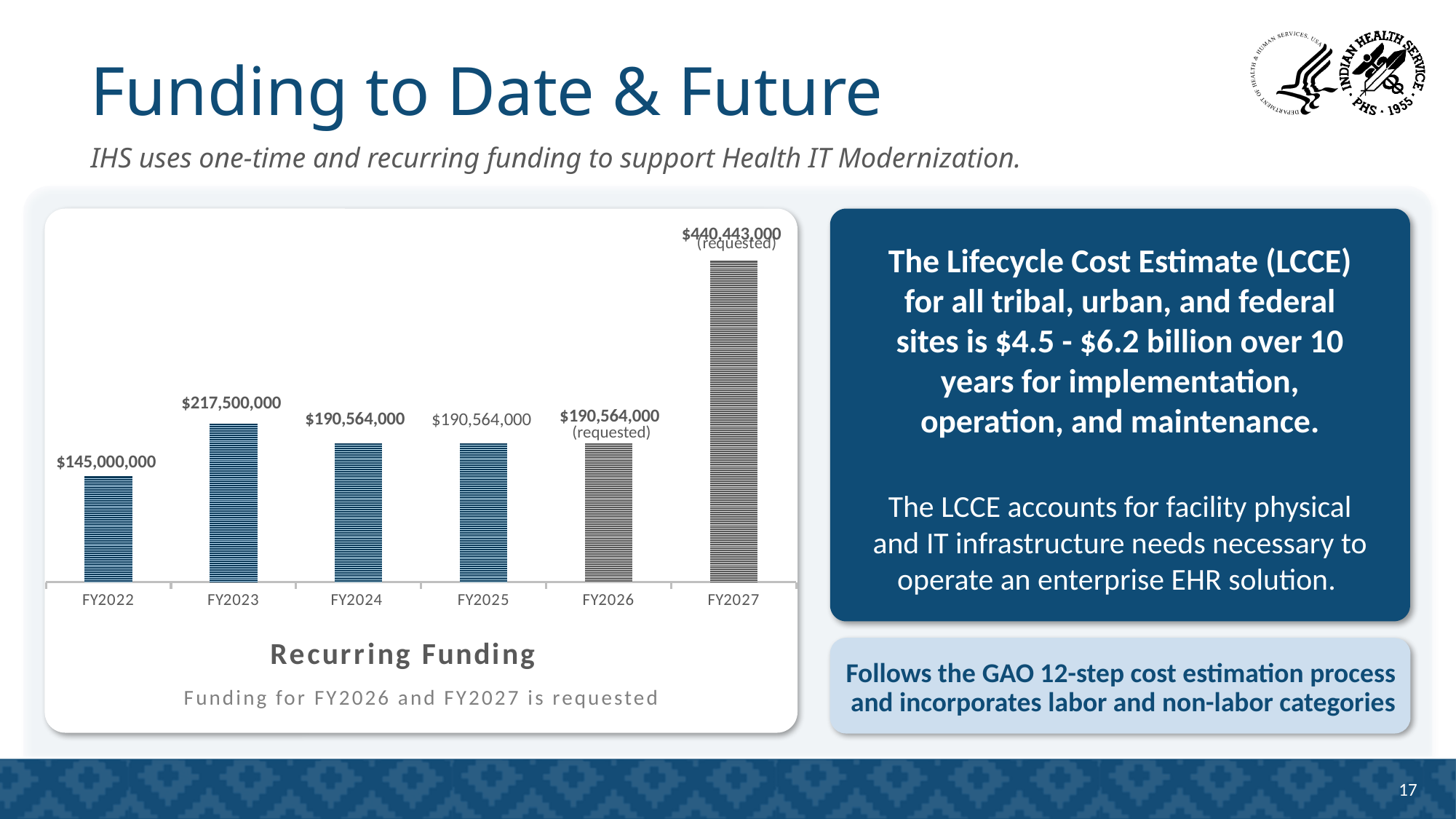
How many fiscal years are shown on the Recurring Funding chart? 6 Which is larger, the recurring funding for FY2023 or for FY2024? FY2023 What is the requested recurring funding value for FY2027? $440,443,000 Which fiscal year has the highest recurring funding value? FY2027 What is the recurring funding value for FY2024? $190,564,000 Which fiscal years on the chart are marked as requested funding? FY2026 and FY2027 What is the recurring funding value for FY2022? $145,000,000 What is the difference between the FY2023 and FY2022 recurring funding values? $72,500,000 What is the recurring funding value for FY2023? $217,500,000 What is the difference between the FY2027 and FY2026 recurring funding values? $249,879,000 What type of chart is the Recurring Funding chart? Bar chart Which fiscal year has the lowest recurring funding value? FY2022